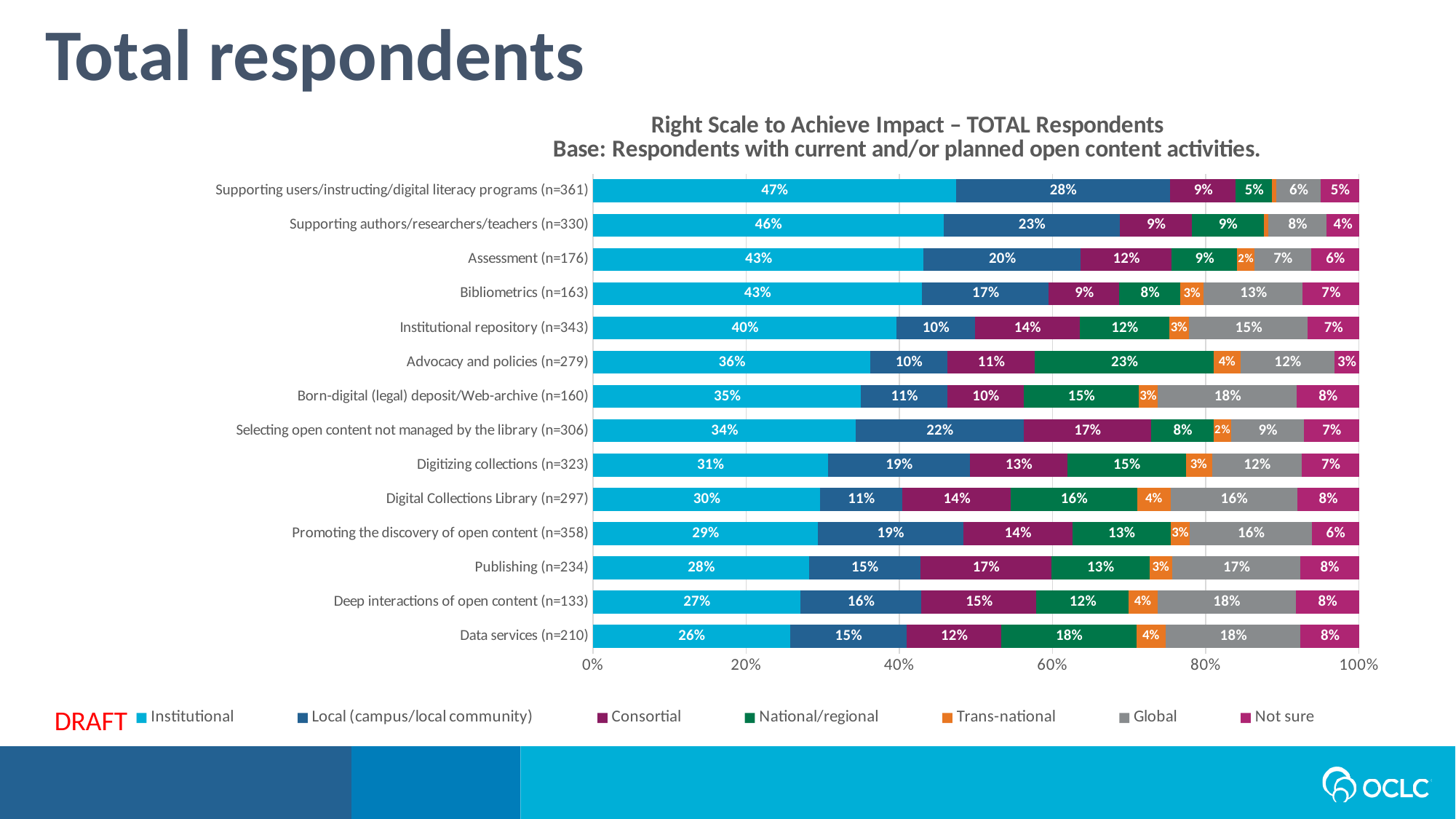
Which category has the lowest Institutional percentage? Data services (n=210) What kind of chart is shown on the slide? Stacked bar chart What percentage of respondents chose Institutional for Bibliometrics (n=163)? 43% Do the Institutional percentages increase or decrease going from the top category to the bottom category? Decrease What is the Global value for Data services (n=210)? 18% What is the National/regional value for Advocacy and policies (n=279)? 23% Which is larger: the Consortial value for Publishing (n=234) or the Consortial value for Digitizing collections (n=323)? Publishing (n=234) What is the title of the chart? Right Scale to Achieve Impact – TOTAL Respondents Base: Respondents with current and/or planned open content activities. Which category has the highest Institutional percentage? Supporting users/instructing/digital literacy programs (n=361) How many series does the legend list? 7 How many categories (activities) are shown in the chart? 14 What is the difference between the Local (campus/local community) values for Supporting users/instructing/digital literacy programs (n=361) and Institutional repository (n=343)? 18%